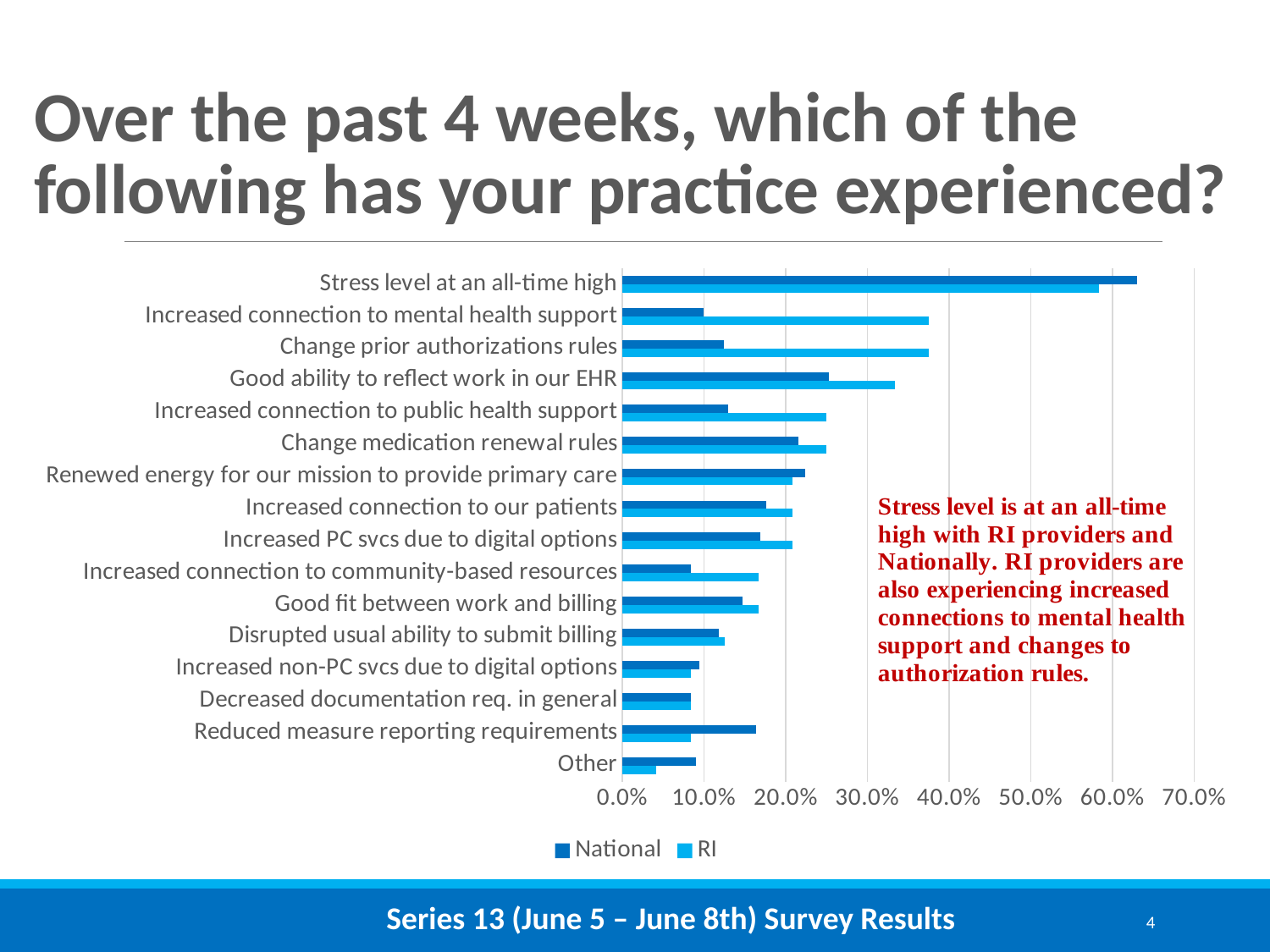
Which category has the highest RI value? Stress level at an all-time high Is the National value for 'Stress level at an all-time high' greater or less than 60.0%? greater For 'Reduced measure reporting requirements', which is larger, the National value or the RI value? National Is the National value for 'Increased connection to mental health support' greater or less than 20.0%? less Which category has the highest National value? Stress level at an all-time high Which series is shown in the darker blue colour in the legend? National How many series does the legend list? 2 How many categories are plotted on the chart? 16 For 'Change prior authorizations rules', which is larger, the National value or the RI value? RI Which category has the lowest RI value? Other What kind of chart is shown on the slide? bar chart Is the RI value for 'Increased connection to mental health support' greater or less than 30.0%? greater